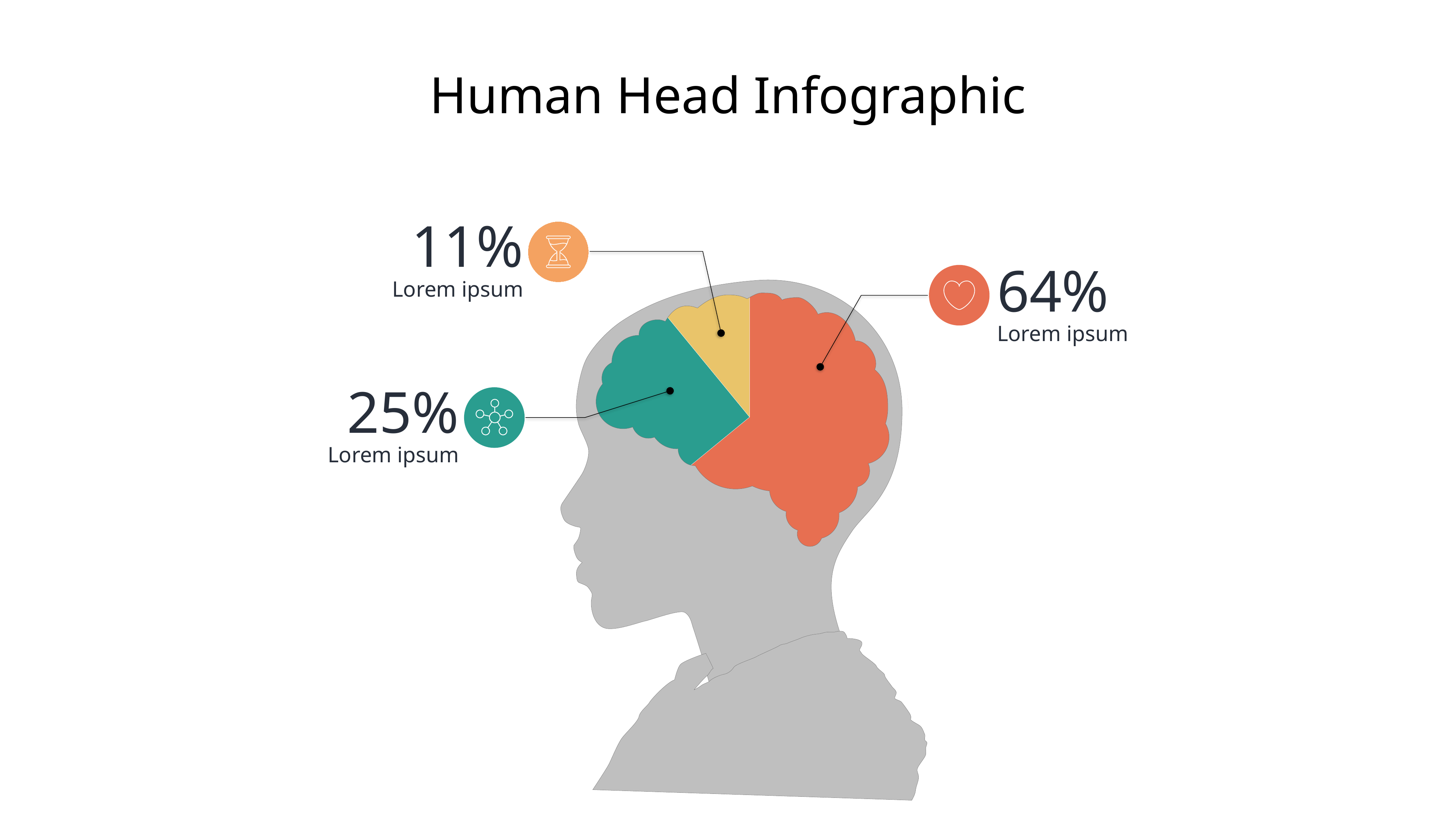
How many segments is the brain divided into? 3 What is the title of the slide? Human Head Infographic What percentage is shown for the orange segment of the brain, marked with the heart icon? 64% Which segment of the brain has the lowest percentage? The yellow segment (11%) What percentage is shown for the teal segment of the brain, marked with the network icon? 25% What percentage is shown for the yellow segment of the brain, marked with the hourglass icon? 11% Which icon is shown in the circle next to the 64% label? A heart What is the difference between the teal segment's percentage and the yellow segment's percentage? 14% What do the three percentages shown on the brain add up to? 100% What is the difference between the largest percentage and the smallest percentage shown on the brain? 53% Which segment of the brain has the highest percentage? The orange segment (64%) Which is larger, the percentage for the teal segment or the percentage for the yellow segment? The teal segment (25%)